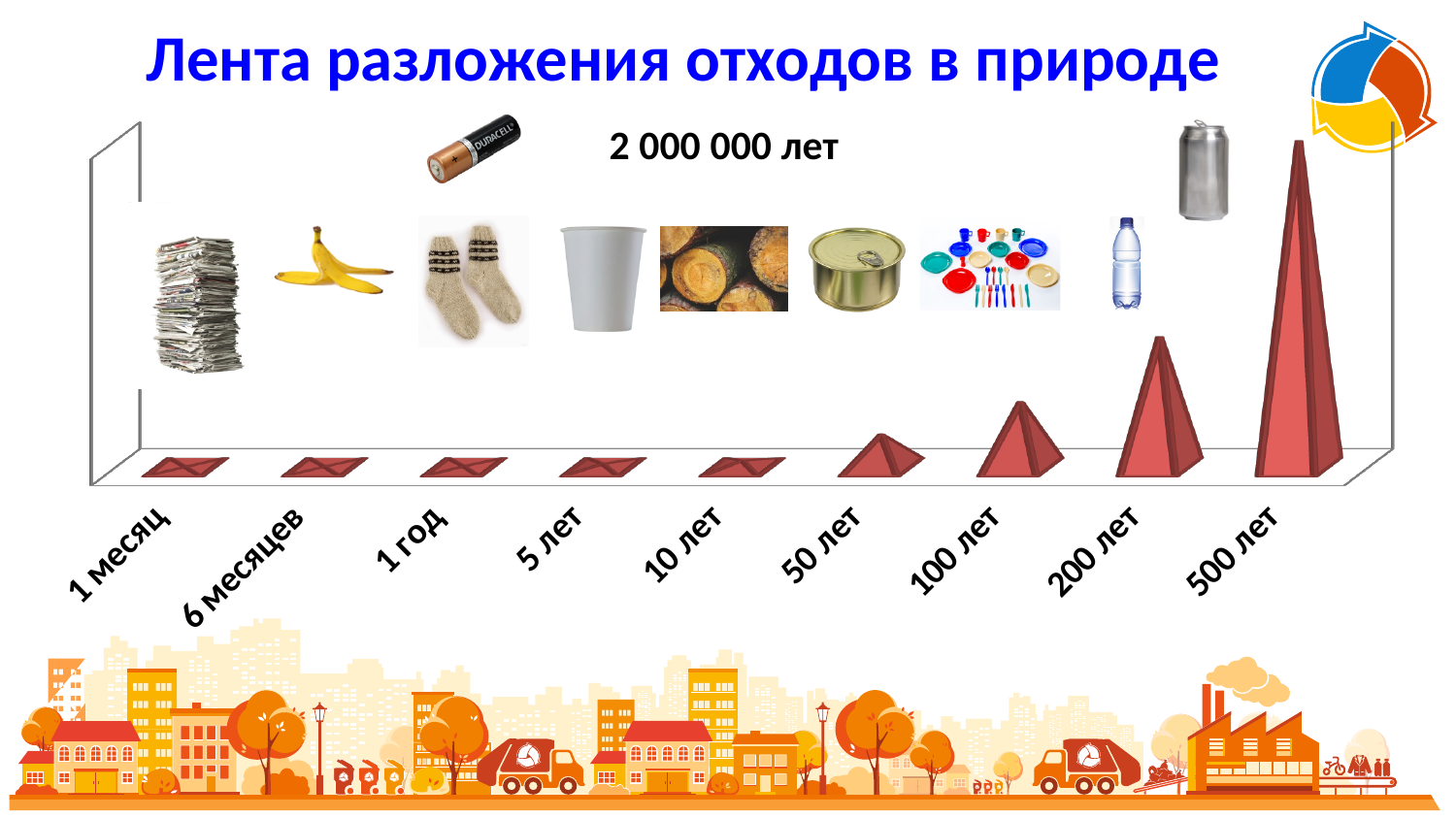
How many categories are shown along the x axis of the chart? 9 What is the label of the category immediately to the left of 500 лет on the x axis? 200 лет Which category has the tallest bar in the chart? 500 лет What is the first category label on the x axis of the chart? 1 месяц Which bar is taller, the one for 50 лет or the one for 100 лет? 100 лет Which bar is taller, the one for 200 лет or the one for 500 лет? 500 лет What is the title of the chart on the slide? Лента разложения отходов в природе Which bar is taller, the one for 100 лет or the one for 200 лет? 200 лет What kind of chart is shown on the slide? bar chart Do the bar heights rise or fall moving from left to right along the x axis? rise What is the label of the category immediately to the right of 1 год on the x axis? 5 лет